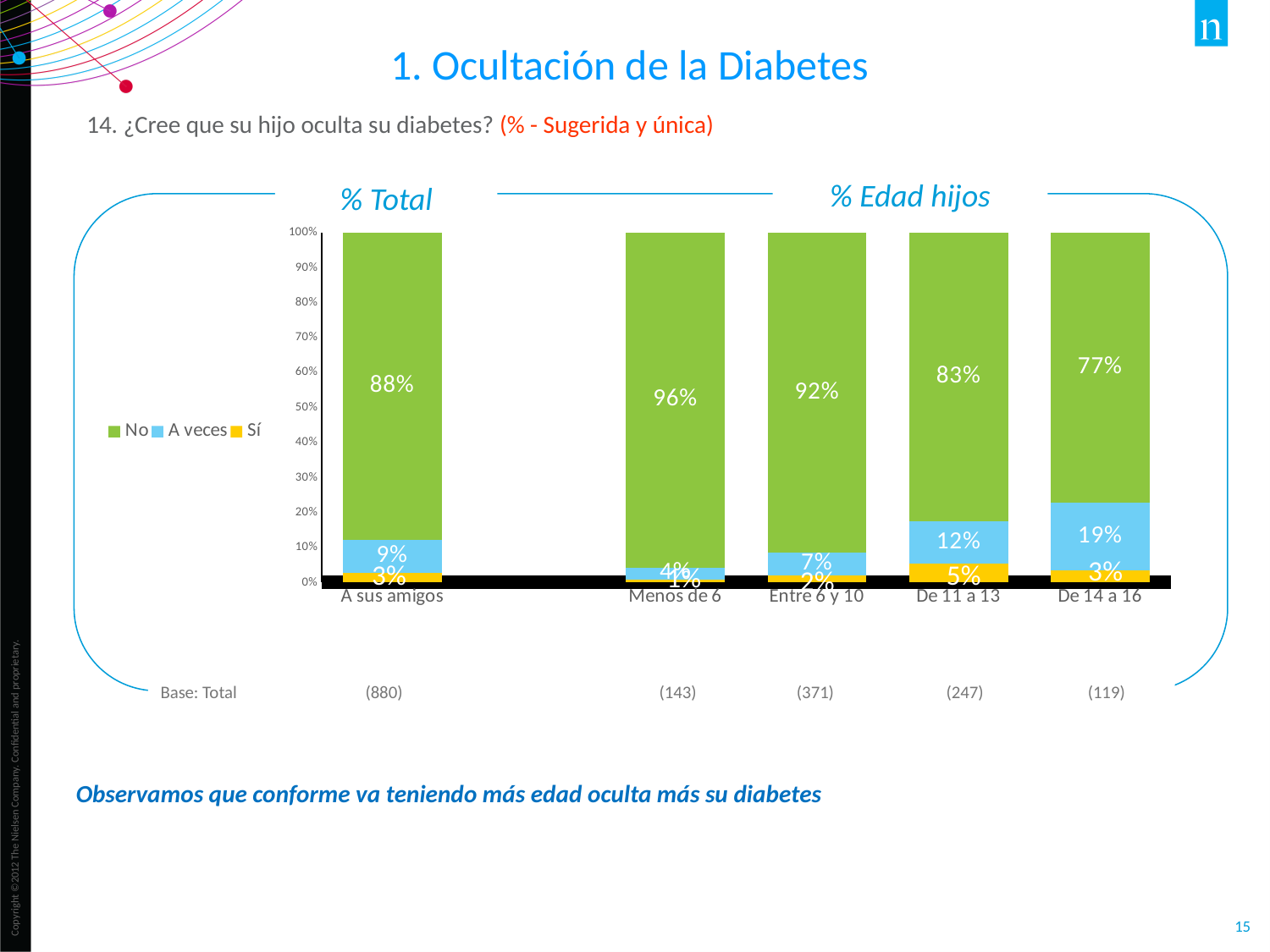
Which category has the lowest value for 'No'? De 14 a 16 Which has the larger 'A veces' value, 'De 11 a 13' or 'De 14 a 16'? De 14 a 16 What is the value of 'No' for 'De 11 a 13'? 83% What kind of chart is shown on the slide? Stacked bar chart What is the value of 'Sí' for 'De 11 a 13'? 5% How many categories are shown along the x axis? 5 How many series does the legend list? 3 What is the value of 'A veces' for 'De 14 a 16'? 19% Which category has the highest value for 'No'? Menos de 6 What is the difference between the 'No' value for 'Menos de 6' and for 'De 14 a 16'? 19 percentage points Does the 'No' value rise or fall across the age groups from 'Menos de 6' to 'De 14 a 16'? Falls What is the value of 'No' for 'A sus amigos'? 88%